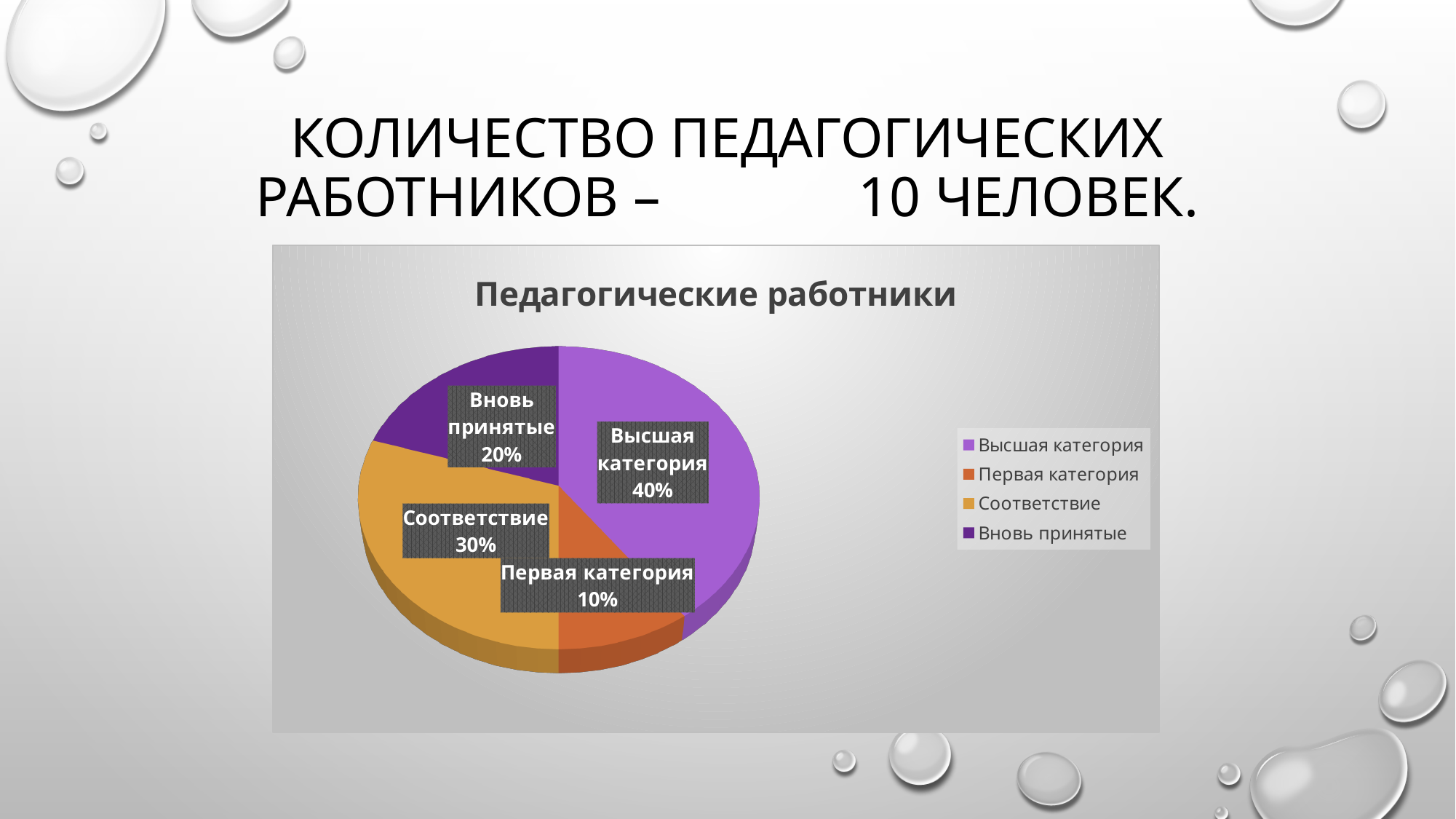
What share of the pie does Соответствие have? 30% Which colour represents Соответствие in the legend? Orange What share of the pie does Высшая категория have? 40% What is the difference in percentage points between Высшая категория and Соответствие? 10% What is the title of the chart? Педагогические работники What type of chart is shown on the slide? Pie chart What share of the pie does Вновь принятые have? 20% Which category has the largest slice of the pie? Высшая категория Which category has the smallest slice of the pie? Первая категория What share of the pie does Первая категория have? 10% How many categories does the pie chart have? 4 Which is larger, Соответствие or Вновь принятые? Соответствие